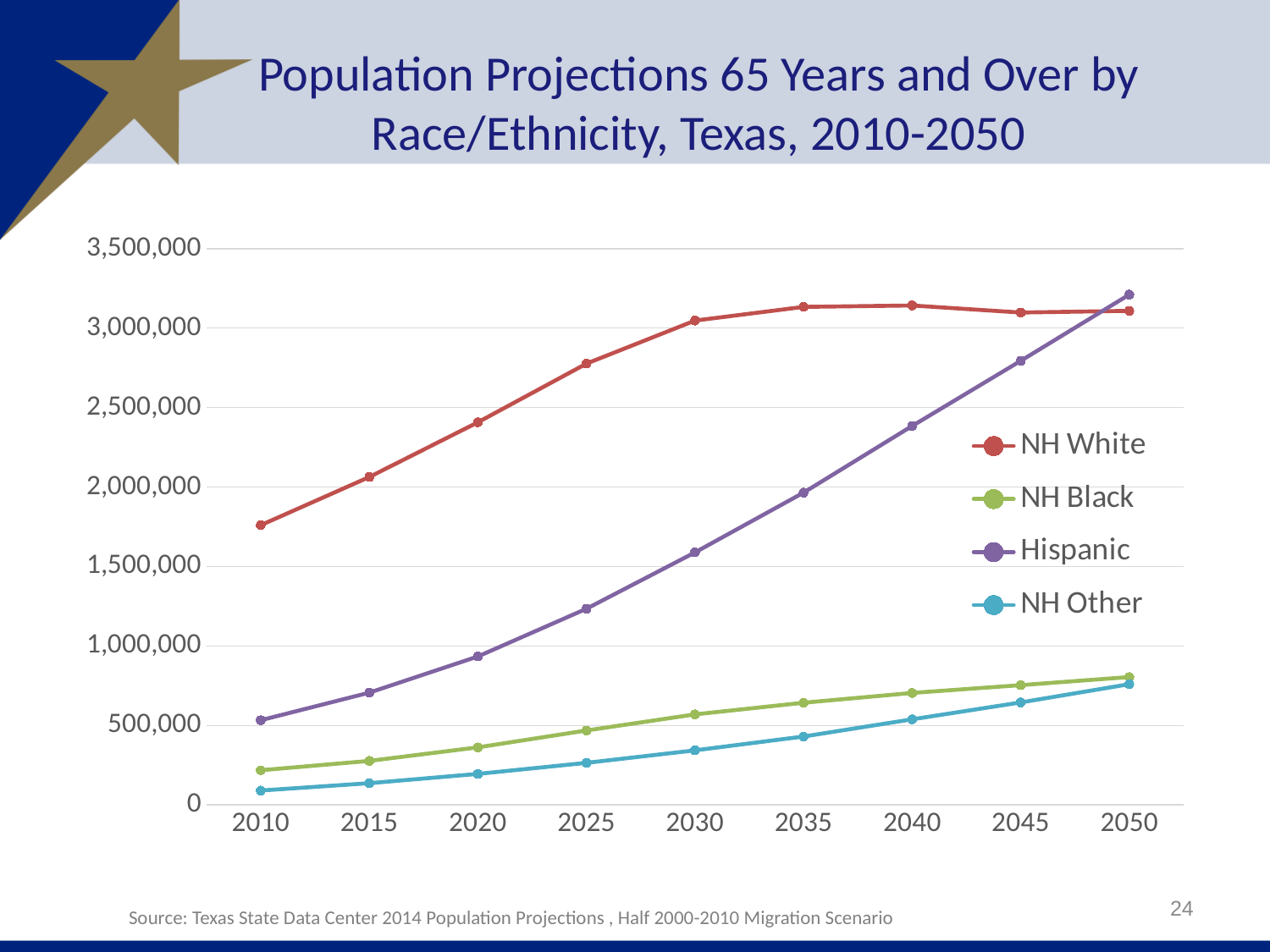
Does the Hispanic series rise or fall from 2010 to 2050? rise Is the NH White value for 2010 greater or less than 2,000,000? less Which race/ethnicity group has the highest projected 65-and-over population in 2050? Hispanic Is the Hispanic value for 2030 greater or less than 1,500,000? greater How many series does the legend list? 4 In 2040, which is larger: the NH White value or the Hispanic value? NH White What kind of chart is shown on the slide? line chart Which race/ethnicity group has the lowest projected 65-and-over population in 2010? NH Other Is the NH White value for 2035 greater or less than 3,000,000? greater In 2030, which is larger: the NH Black value or the NH Other value? NH Black Which race/ethnicity group has the highest projected 65-and-over population in 2010? NH White How many years are shown along the x axis? 9